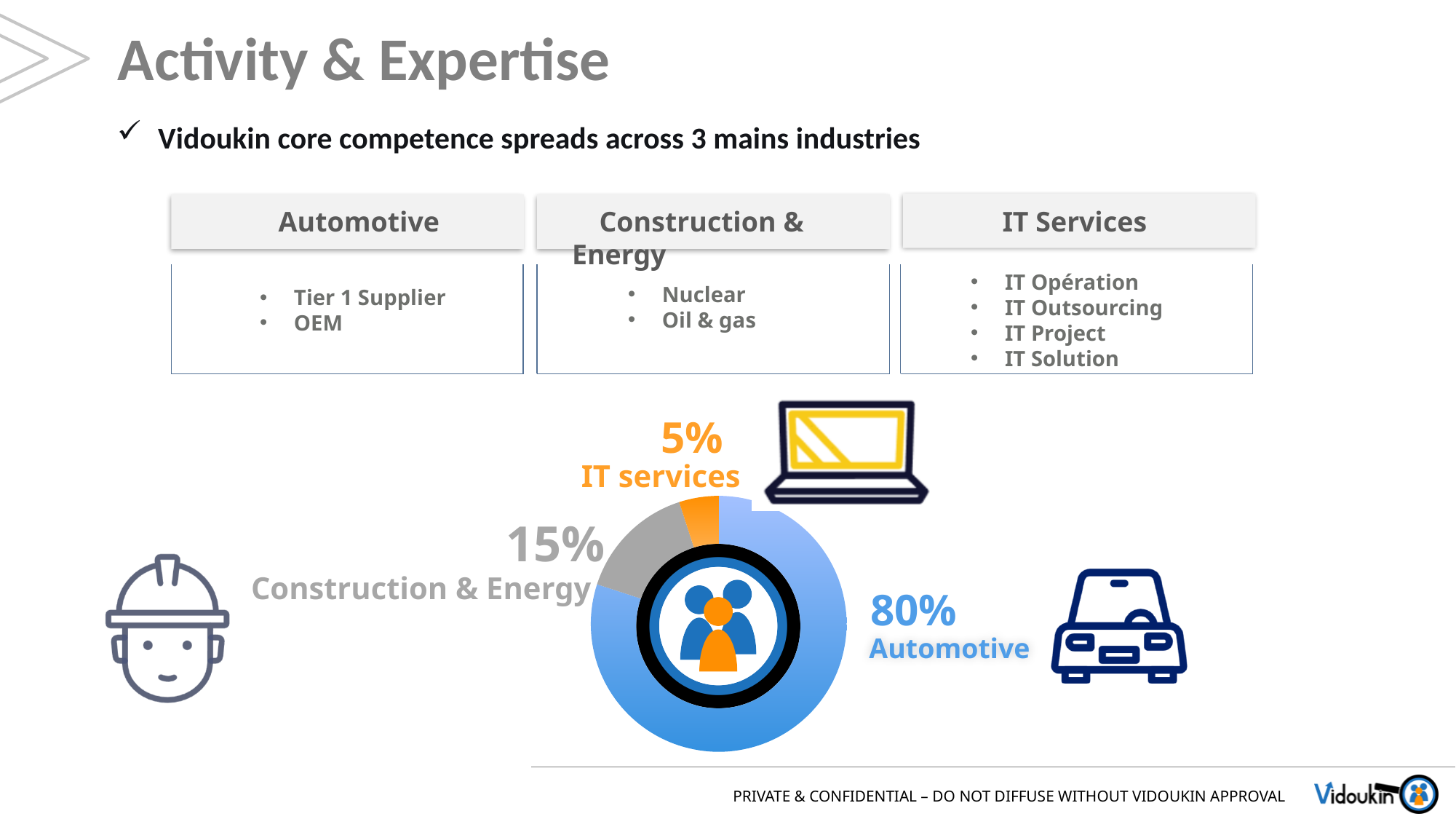
Which industry has the largest slice in the pie chart? Automotive What colour is the IT services slice of the pie chart? Orange What is the difference in percentage points between the Automotive and Construction & Energy slices? 65 What share of the pie chart does IT services represent? 5% What is the difference in percentage points between the Construction & Energy and IT services slices? 10 How many slices does the pie chart have? 3 Which slice is larger, Construction & Energy or IT services? Construction & Energy What share of the pie chart does Automotive represent? 80% What share of the pie chart does Construction & Energy represent? 15% Which industry has the smallest slice in the pie chart? IT services What colour is the Automotive slice of the pie chart? Blue What kind of chart is shown on the slide? Doughnut (ring) chart